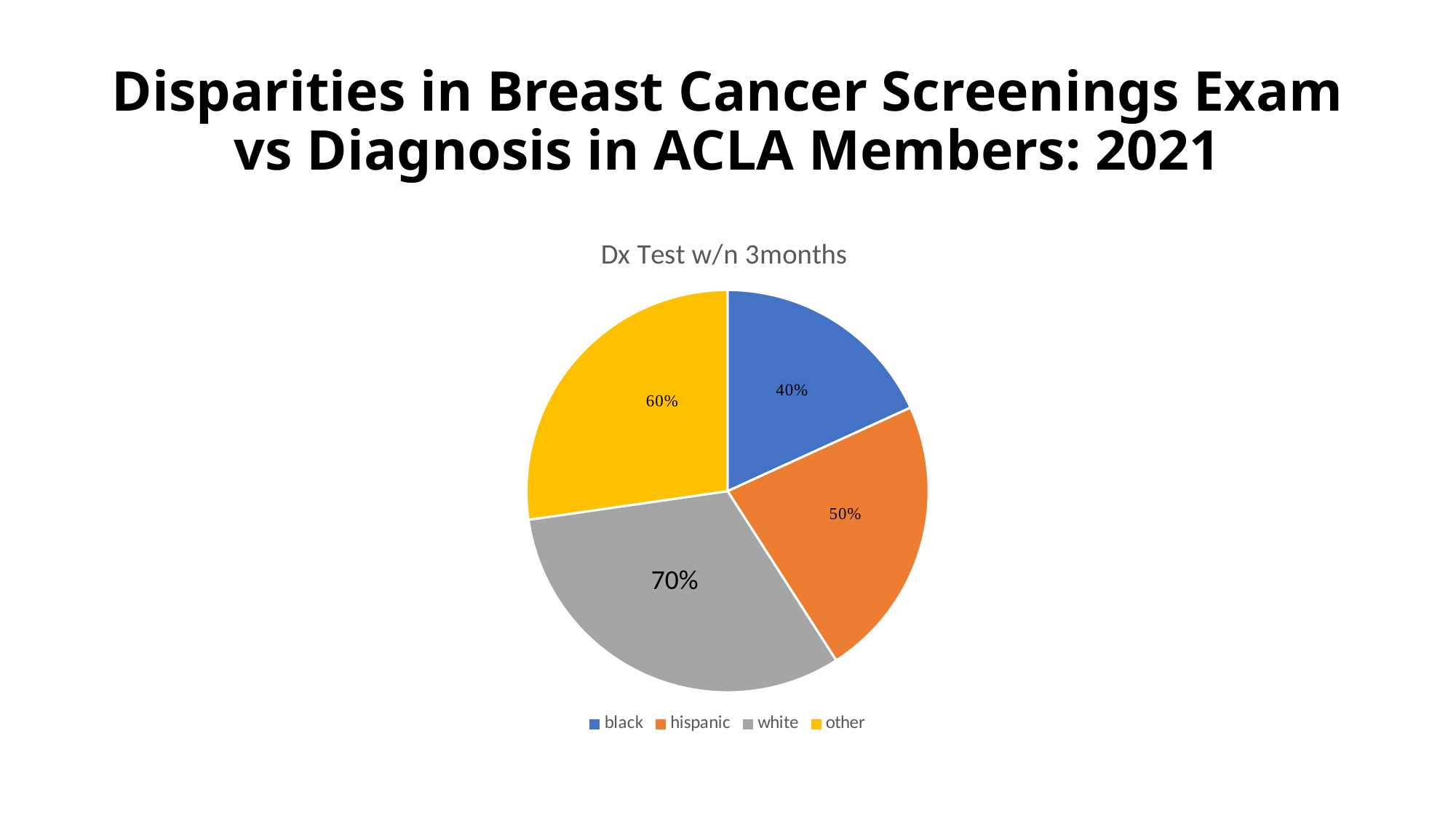
What is the title of the chart? Dx Test w/n 3months Which category has the lowest value? black What value is shown for the other slice? 60% Which category has the highest value? white What type of chart is shown on the slide? pie chart How many categories does the pie chart have? 4 Which is larger, the value for hispanic or the value for other? other What value is shown for the hispanic slice? 50% What colour is the slice for hispanic? orange What value is shown for the white slice? 70% What value is shown for the black slice? 40% What is the difference between the white value and the black value? 30%